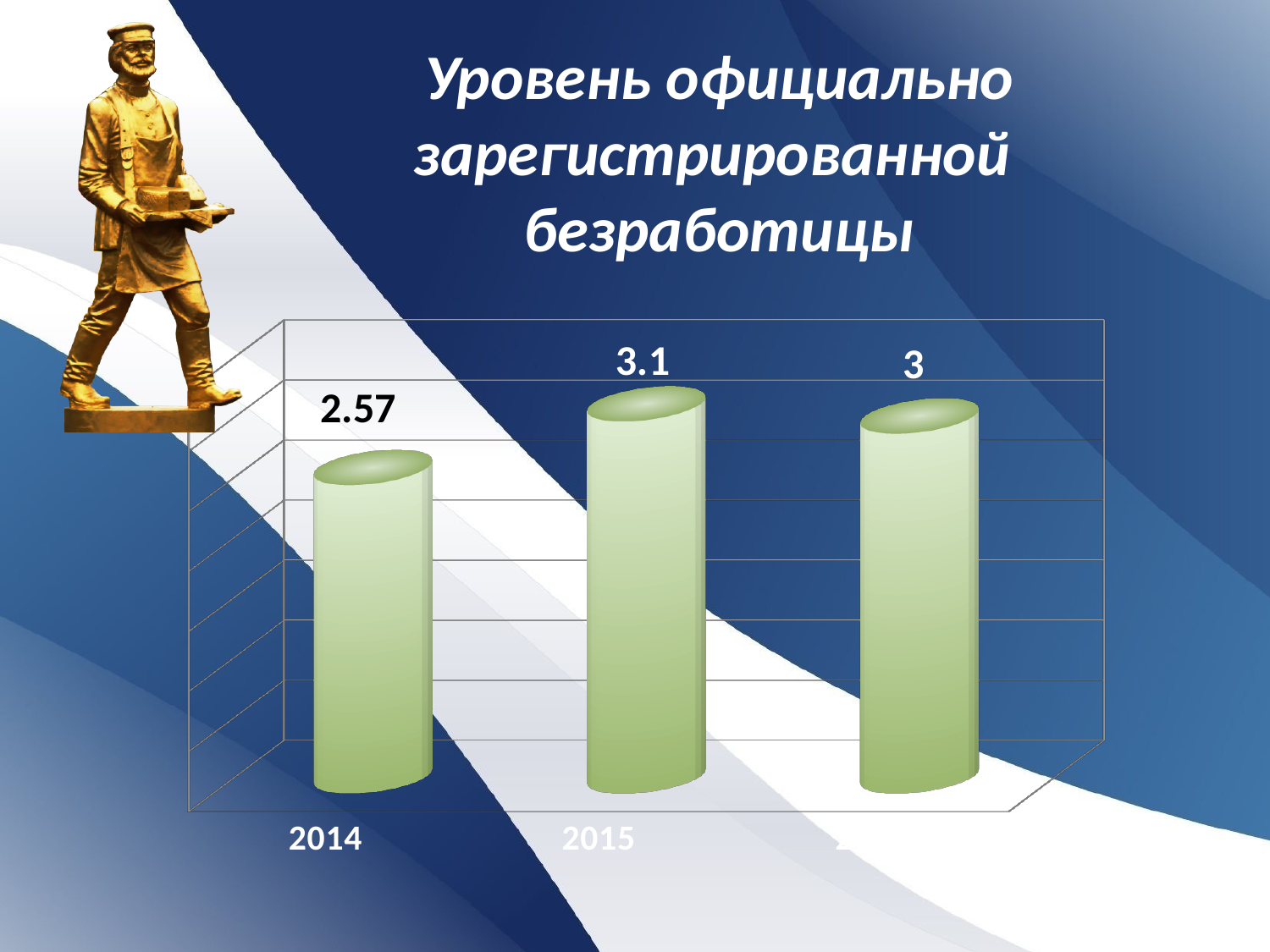
What is the value for 2015? 3.1 What is the difference between the values for 2015 and 2014? 0.53 What colour are the bars in the chart? Green Which is larger, the value for 2014 or the value for 2015? 2015 Does the value rise or fall from 2014 to 2015? Rise What is the value shown on the rightmost bar? 3 Which year has the lowest value? 2014 Which year has the highest value? 2015 What is the value for 2014? 2.57 How many bars are plotted in the chart? 3 What is the title of the slide above the chart? Уровень официально зарегистрированной безработицы What kind of chart is shown on the slide? Bar chart